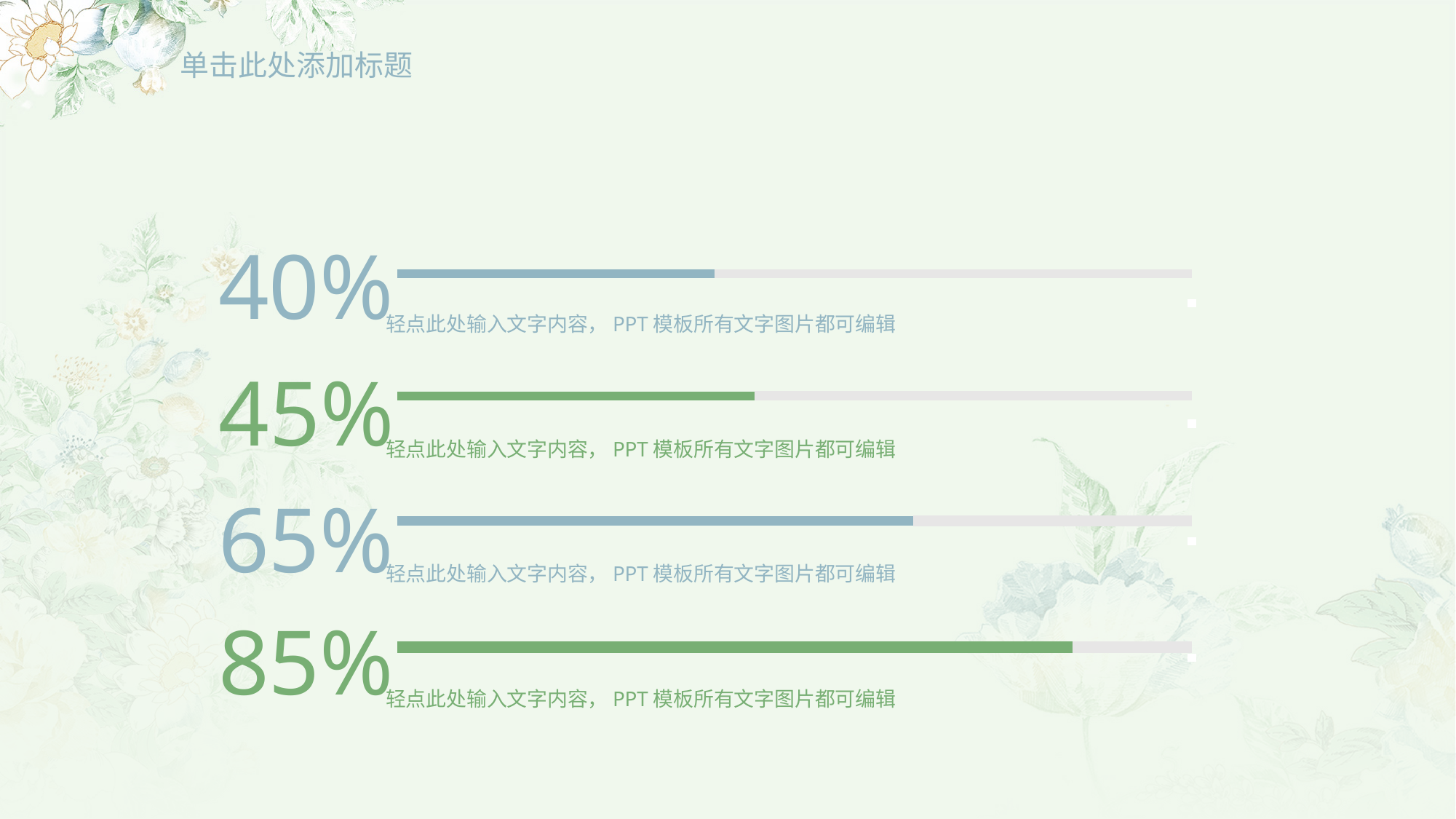
What colour is the filled portion of the bottom (85%) bar? Green Which is larger, the value of the second bar or the value of the third bar? The third bar (65%) What value is shown for the first (top) progress bar? 40% Which progress bar has the lowest value? The first (top) bar, 40% Which progress bar has the highest value? The fourth (bottom) bar, 85% What is the difference between the bottom bar's value and the top bar's value? 45% How many progress bars are shown on the slide? 4 What value is shown for the third progress bar from the top? 65% What is the difference between the third bar's value and the second bar's value? 20% What value is shown for the fourth (bottom) progress bar? 85% What value is shown for the second progress bar from the top? 45% Do the values increase or decrease going from the top bar to the bottom bar? Increase